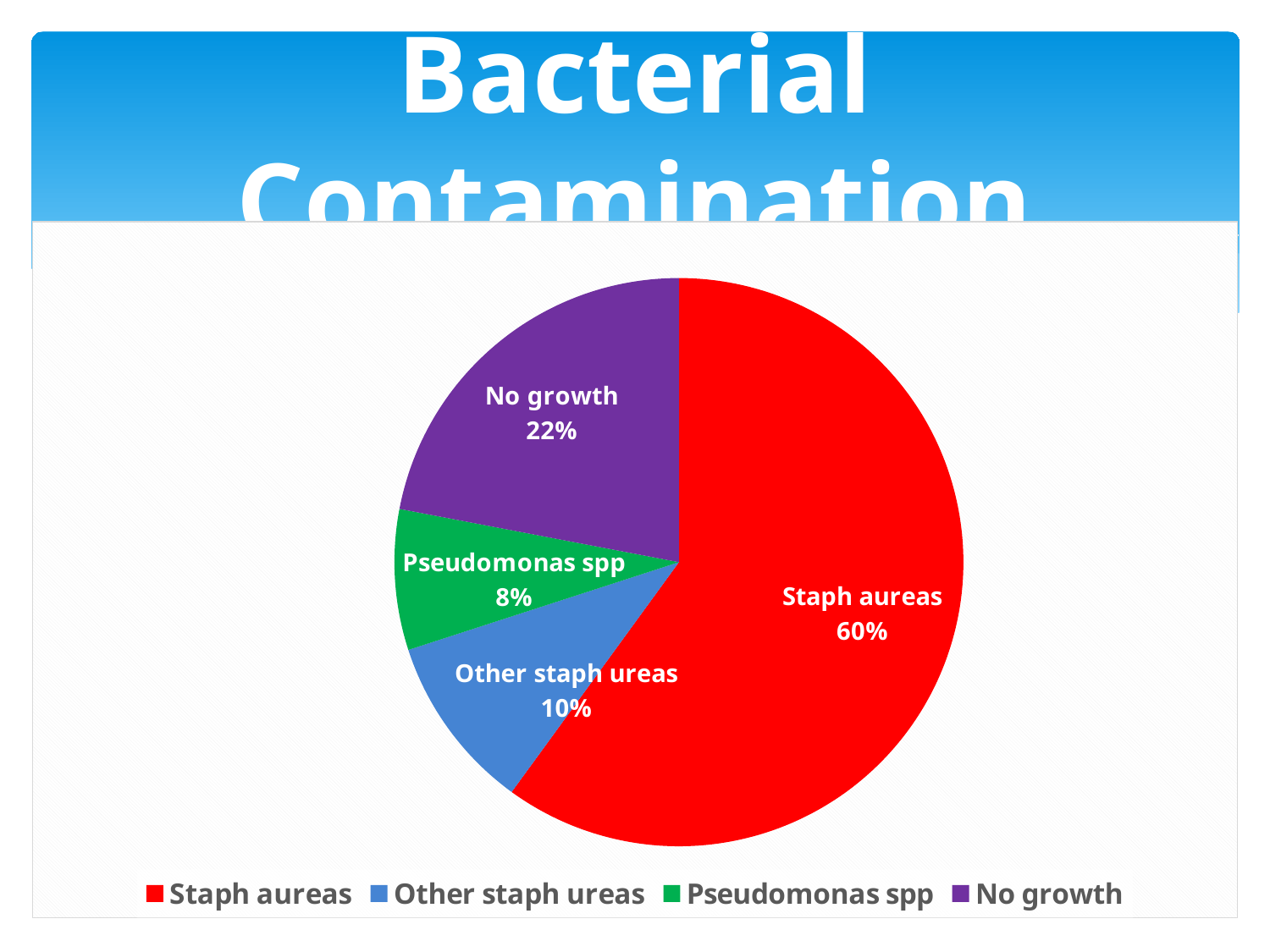
How many slices does the pie chart have? 4 What percentage of the pie is No growth? 22% What kind of chart is shown on the slide? pie chart What colour is the No growth slice? purple What percentage of the pie is Other staph ureas? 10% Which category has the smallest slice of the pie? Pseudomonas spp Which category has the largest slice of the pie? Staph aureas What is the difference in percentage points between Staph aureas and No growth? 38 What percentage of the pie is Staph aureas? 60% What percentage of the pie is Pseudomonas spp? 8% How many entries does the legend list? 4 Which is larger, the slice for Other staph ureas or the slice for Pseudomonas spp? Other staph ureas